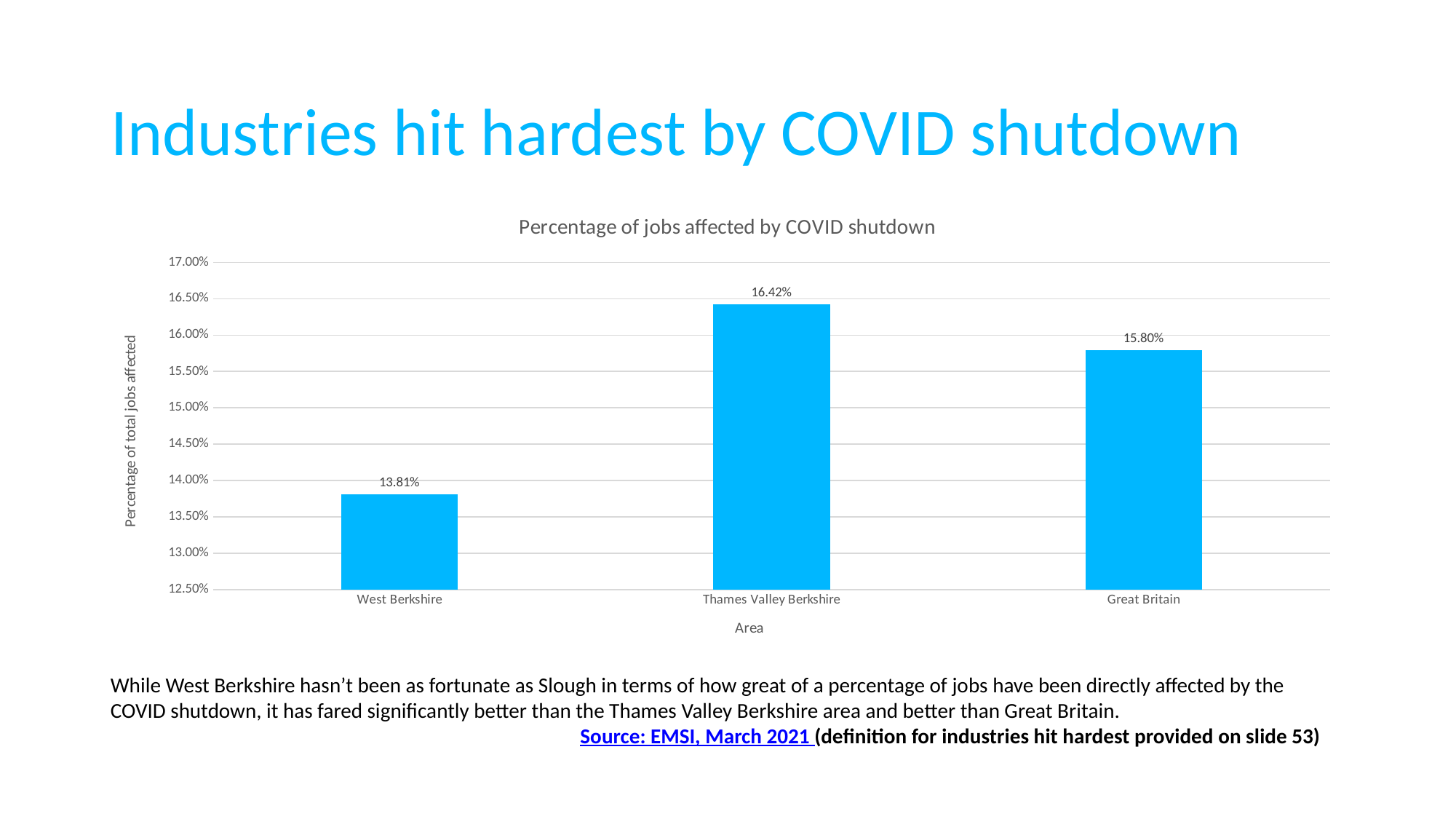
Which area has the lowest percentage of jobs affected by COVID shutdown? West Berkshire How many areas are shown in the chart? 3 What is the percentage of jobs affected by COVID shutdown for Great Britain? 15.80% Which area has the highest percentage of jobs affected by COVID shutdown? Thames Valley Berkshire What is the percentage of jobs affected by COVID shutdown for Thames Valley Berkshire? 16.42% What type of chart is shown on the slide? Bar chart What is the difference in percentage points between Thames Valley Berkshire and West Berkshire? 2.61% Which has a higher percentage of jobs affected, Great Britain or West Berkshire? Great Britain What is the difference in percentage points between Thames Valley Berkshire and Great Britain? 0.62% Is the value for Great Britain greater or less than 16.00%? less What is the percentage of jobs affected by COVID shutdown for West Berkshire? 13.81% What is the title of the chart? Percentage of jobs affected by COVID shutdown